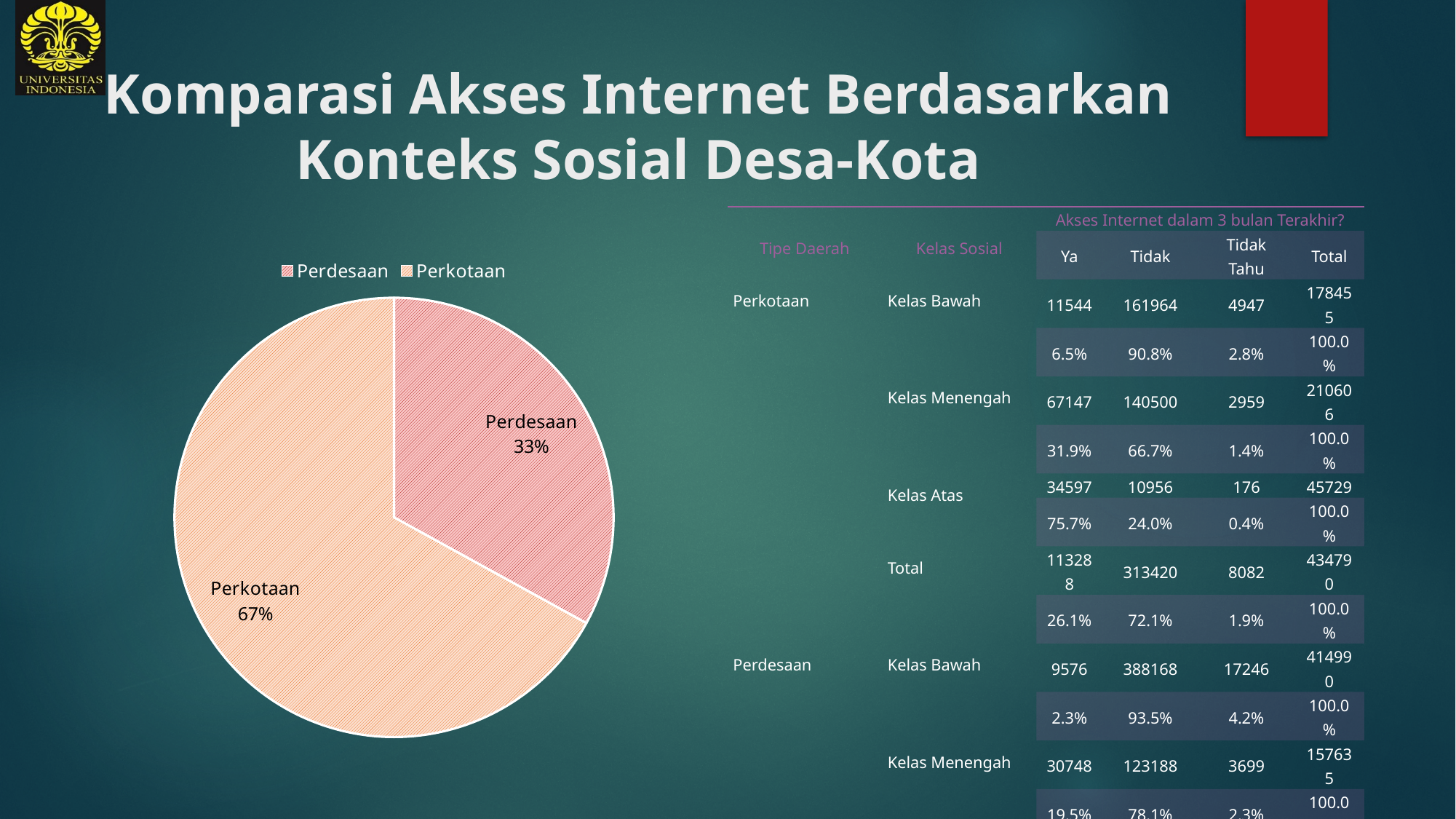
Which slice of the pie chart is the largest? Perkotaan What is the difference in percentage points between the Perkotaan and Perdesaan slices? 34 Which slice of the pie chart is the smallest? Perdesaan What share of the pie chart does Perdesaan represent? 33% What kind of chart is shown on the slide? pie chart Is the share for Perdesaan in the pie chart greater or less than 50%? less What share of the pie chart does Perkotaan represent? 67% How many entries does the pie chart's legend list? 2 Which is larger in the pie chart, Perdesaan or Perkotaan? Perkotaan How many slices does the pie chart have? 2 What are the two entries listed in the pie chart's legend? Perdesaan and Perkotaan